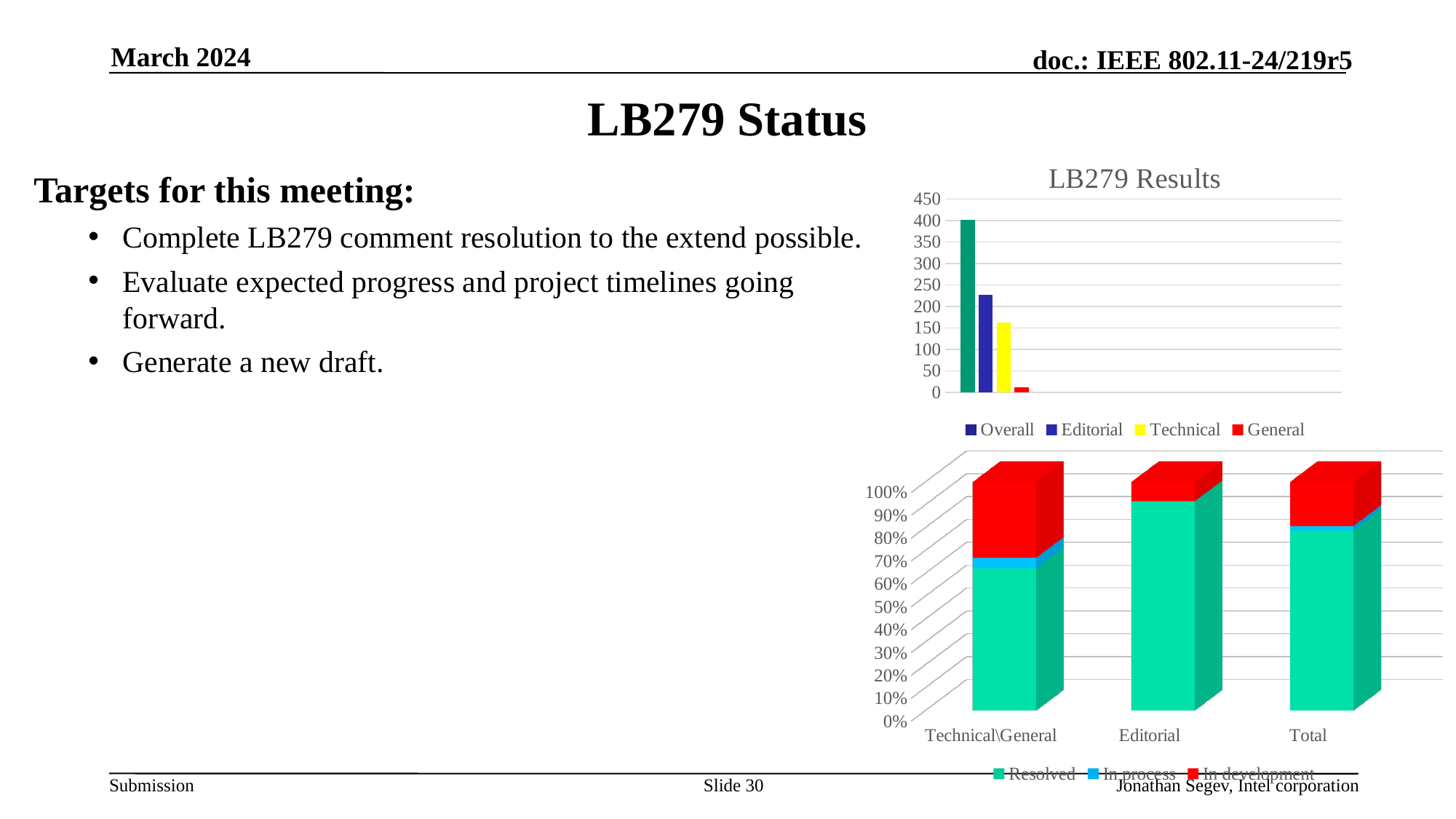
In the bottom stacked bar chart, which category has the largest Resolved share? Editorial How many series does the legend of the bottom stacked bar chart list? 3 In the top chart "LB279 Results", which is larger, Editorial or Technical? Editorial In the top chart "LB279 Results", is the value for Overall greater or less than 350? greater How many series does the legend of the top chart "LB279 Results" list? 4 What kind of chart is the top chart titled "LB279 Results"? bar chart In the top chart "LB279 Results", which series has the highest value? Overall How many categories are shown on the x axis of the bottom stacked bar chart? 3 In the top chart "LB279 Results", is the value for Technical greater or less than 200? less In the top chart "LB279 Results", is the value for Editorial greater or less than 200? greater In the top chart "LB279 Results", which series has the lowest value? General What kind of chart is the bottom chart with categories Technical\General, Editorial and Total? stacked bar chart